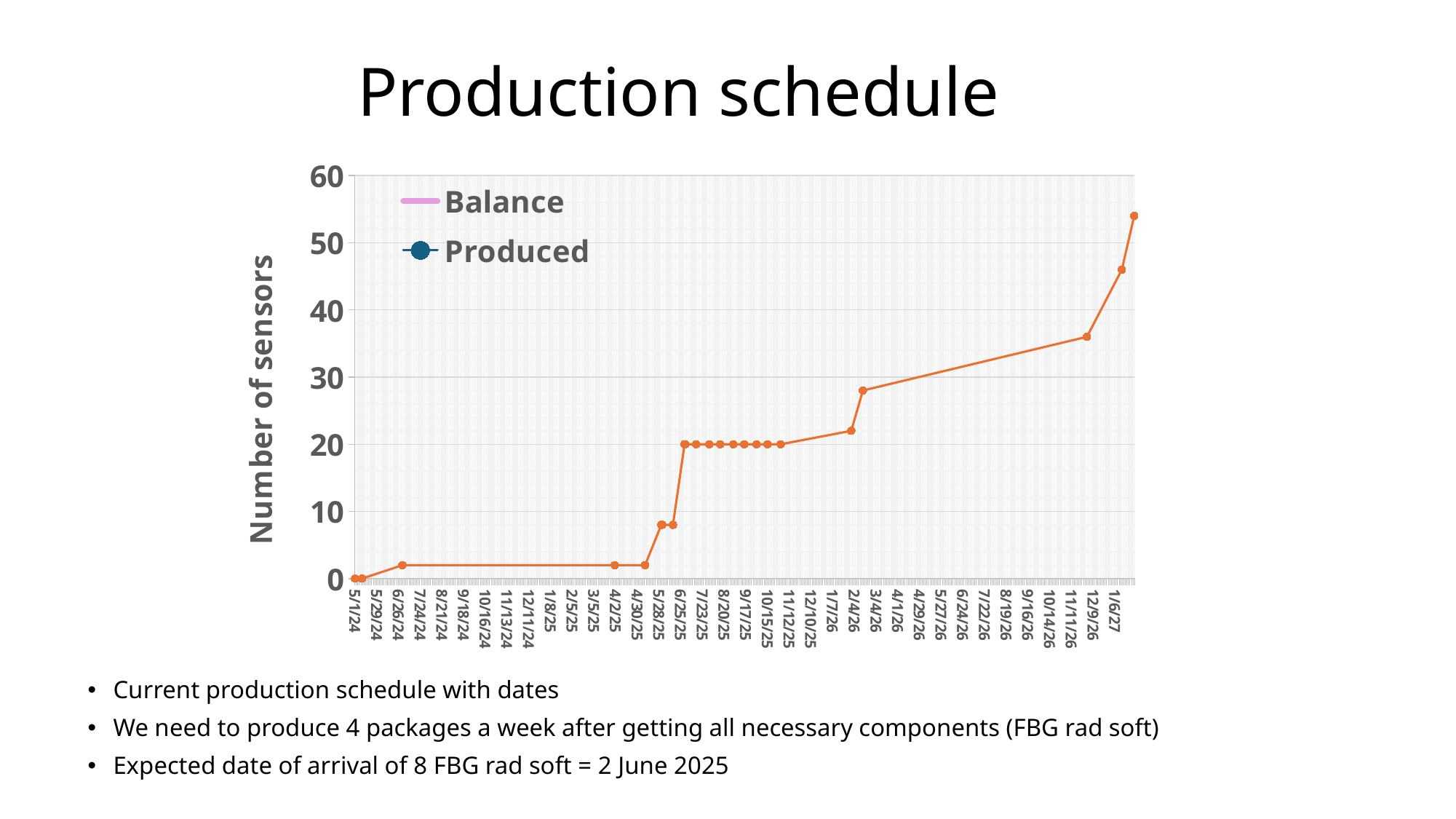
What are the two series named in the legend? Balance and Produced What is the label of the vertical axis? Number of sensors Is the value at 12/9/26 greater or less than 30? greater How many series does the legend list? 2 What is the number of sensors at 7/23/25? 20 What is the number of sensors at 5/1/24? 0 What is the number of sensors at 11/12/25? 20 Which is larger, the value at 3/4/26 or the value at 2/4/26? 3/4/26 What kind of chart is shown on the slide? Line chart Is the value at 5/28/25 greater or less than 10? less Is the value at 1/6/27 greater or less than 40? greater Do the plotted values rise or fall along the x axis from 5/1/24 to 1/6/27? Rise